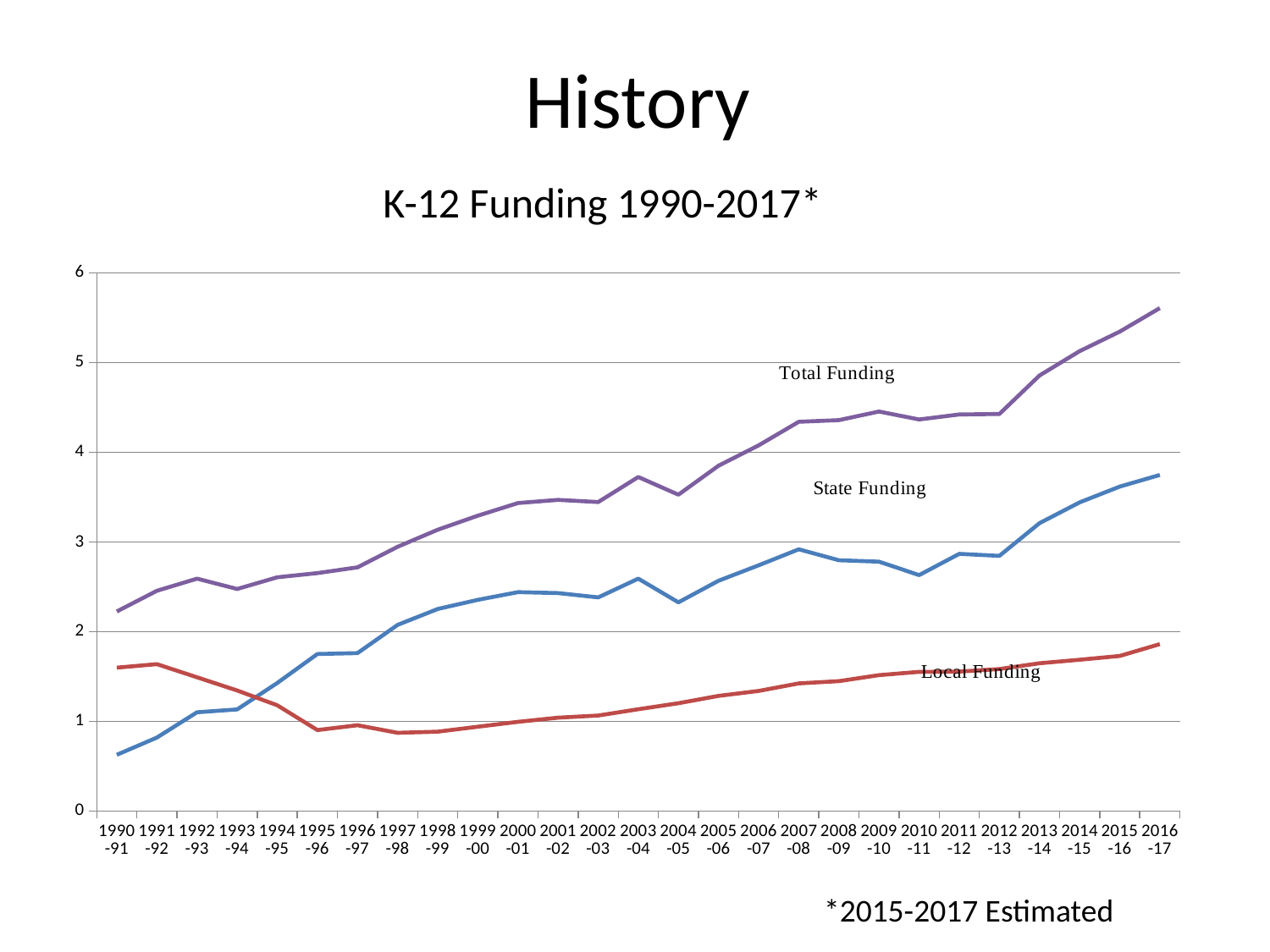
How many school years are shown along the x axis? 27 Is the value for State Funding in 1990-91 greater or less than 1? less In 1990-91, which is larger: State Funding or Local Funding? Local Funding In 2016-17, which is larger: State Funding or Local Funding? State Funding Overall, does Total Funding rise or fall from 1990-91 to 2016-17? rise Is the value for Total Funding in 2016-17 greater or less than 5? greater In which school year is State Funding at its lowest? 1990-91 How many lines (series) are plotted on the chart? 3 Is the value for State Funding in 2016-17 greater or less than 3? greater In which school year is Total Funding at its highest? 2016-17 What kind of chart is shown on the slide? line chart